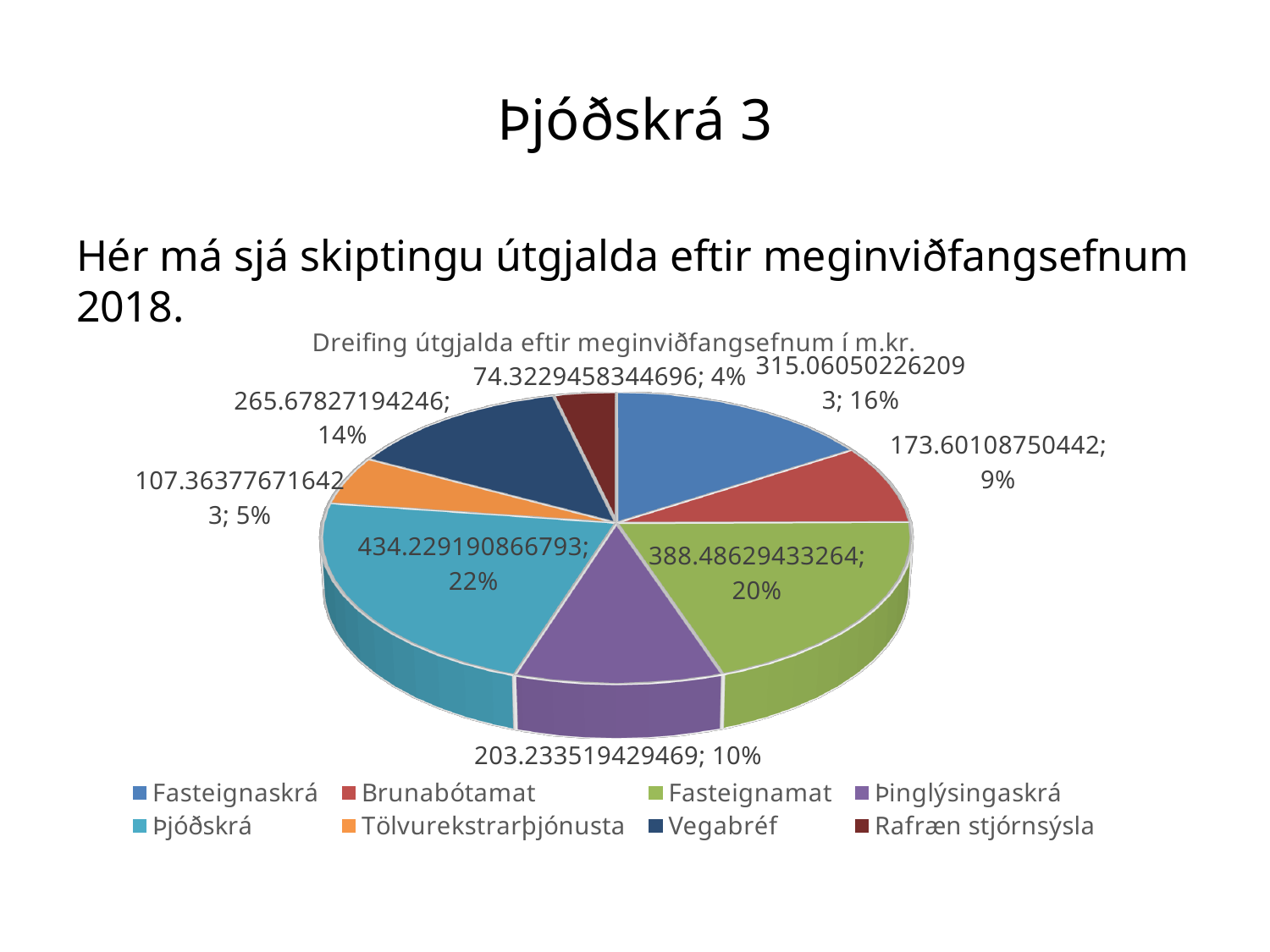
What share of the pie does Þjóðskrá represent? 22% Which is larger, the slice for Fasteignaskrá or the slice for Brunabótamat? Fasteignaskrá Which category has the smallest slice of the pie? Rafræn stjórnsýsla What colour is the slice for Tölvurekstrarþjónusta? orange What kind of chart is shown on the slide? pie chart What is the title of the chart? Dreifing útgjalda eftir meginviðfangsefnum í m.kr. What is the difference in percentage points between the share for Þjóðskrá and the share for Þinglýsingaskrá? 12 percentage points What share of the pie does Rafræn stjórnsýsla represent? 4% Which category has the largest slice of the pie? Þjóðskrá What share of the pie does Vegabréf represent? 14% How many categories does the legend of the pie chart list? 8